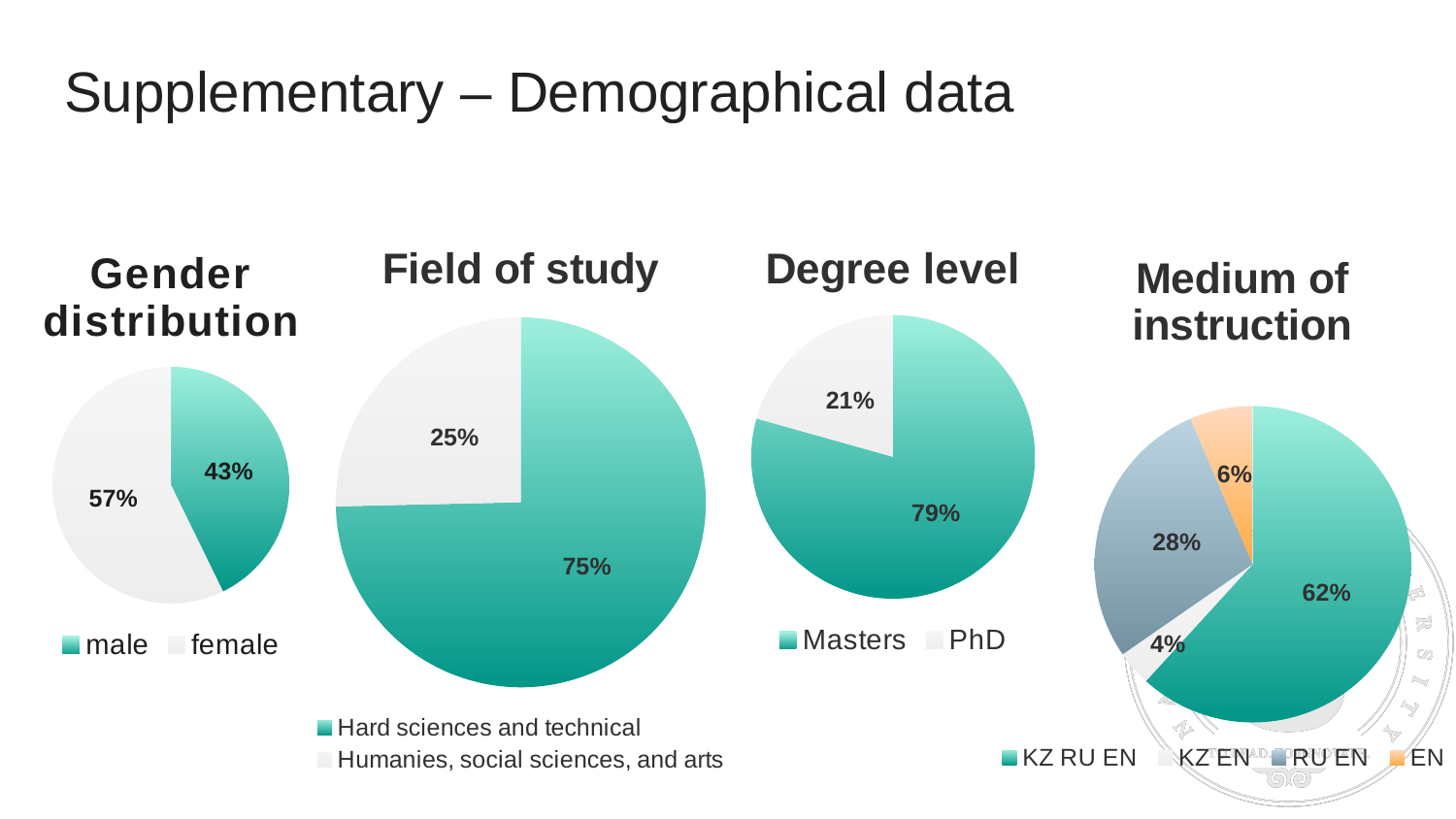
In the Medium of instruction chart, how many categories are shown? 4 In the Degree level chart, what share is PhD? 21% How many charts are on the slide? 4 In the Degree level chart, which category is the largest? Masters In the Medium of instruction chart, which category is the smallest? KZ EN In the Medium of instruction chart, what share is RU EN? 28% In the Gender distribution chart, which is larger, male or female? female What kind of chart is the Medium of instruction chart? pie chart In the Field of study chart, what is the difference between the Hard sciences and technical share and the Humanities, social sciences, and arts share? 50% In the Gender distribution chart, what share is male? 43%